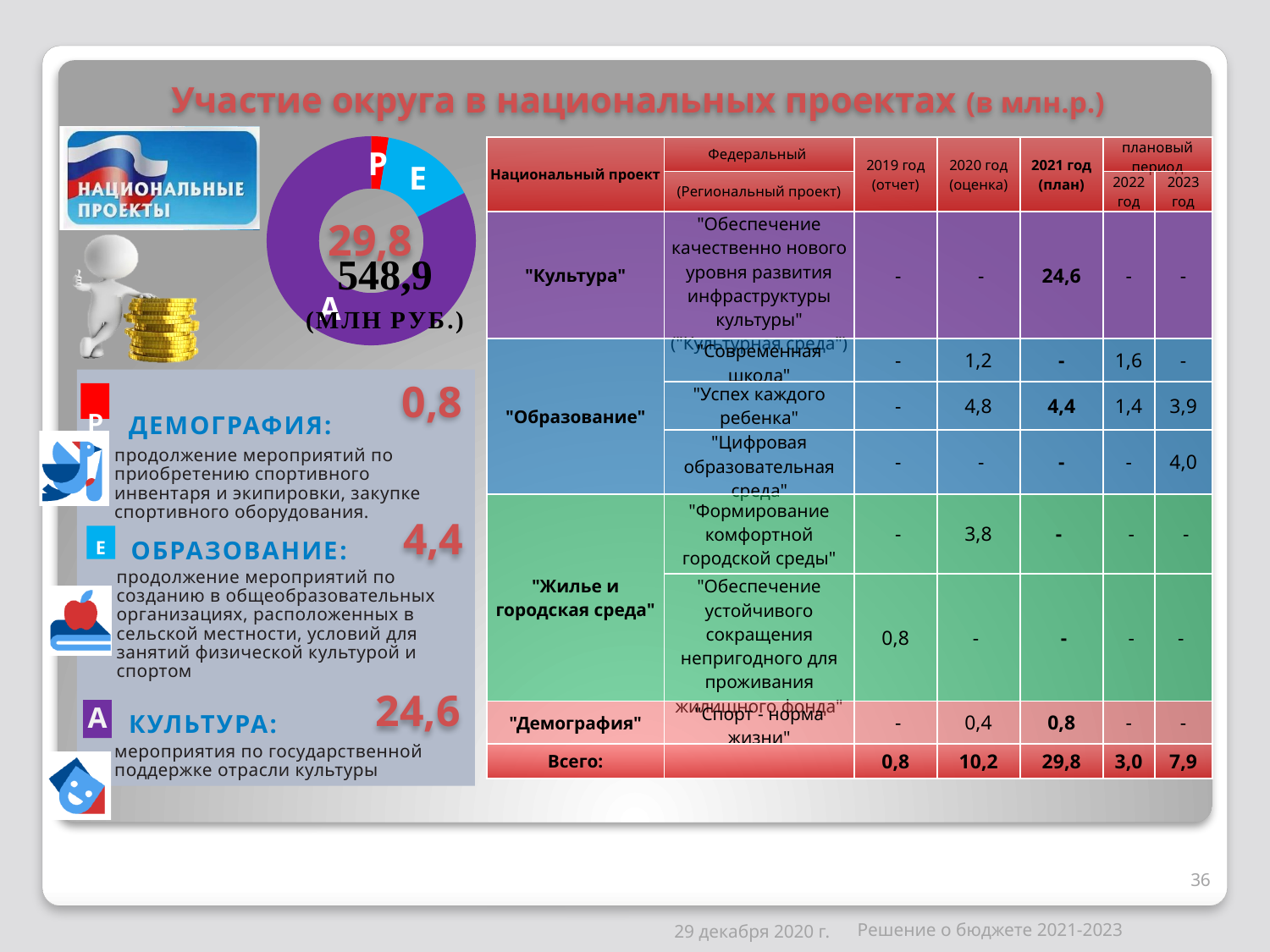
What is the value for Образование (slice Е) in the pie chart, in million rubles? 4,4 What is the value for Культура (slice А) in the pie chart, in million rubles? 24,6 Which category has the smallest slice in the pie chart? Демография What colour is the Культура (А) slice in the pie chart? purple What is the difference between the values for Культура and Образование in the pie chart? 20,2 What is the value for Демография (slice Р) in the pie chart, in million rubles? 0,8 How many slices does the pie chart have? 3 What kind of chart is shown on the left of the slide? doughnut chart Which is larger in the pie chart, the value for Образование or the value for Демография? Образование What is the difference between the values for Образование and Демография in the pie chart? 3,6 Which category has the largest slice in the pie chart? Культура What total is printed in the centre of the pie chart for the three national projects? 29,8